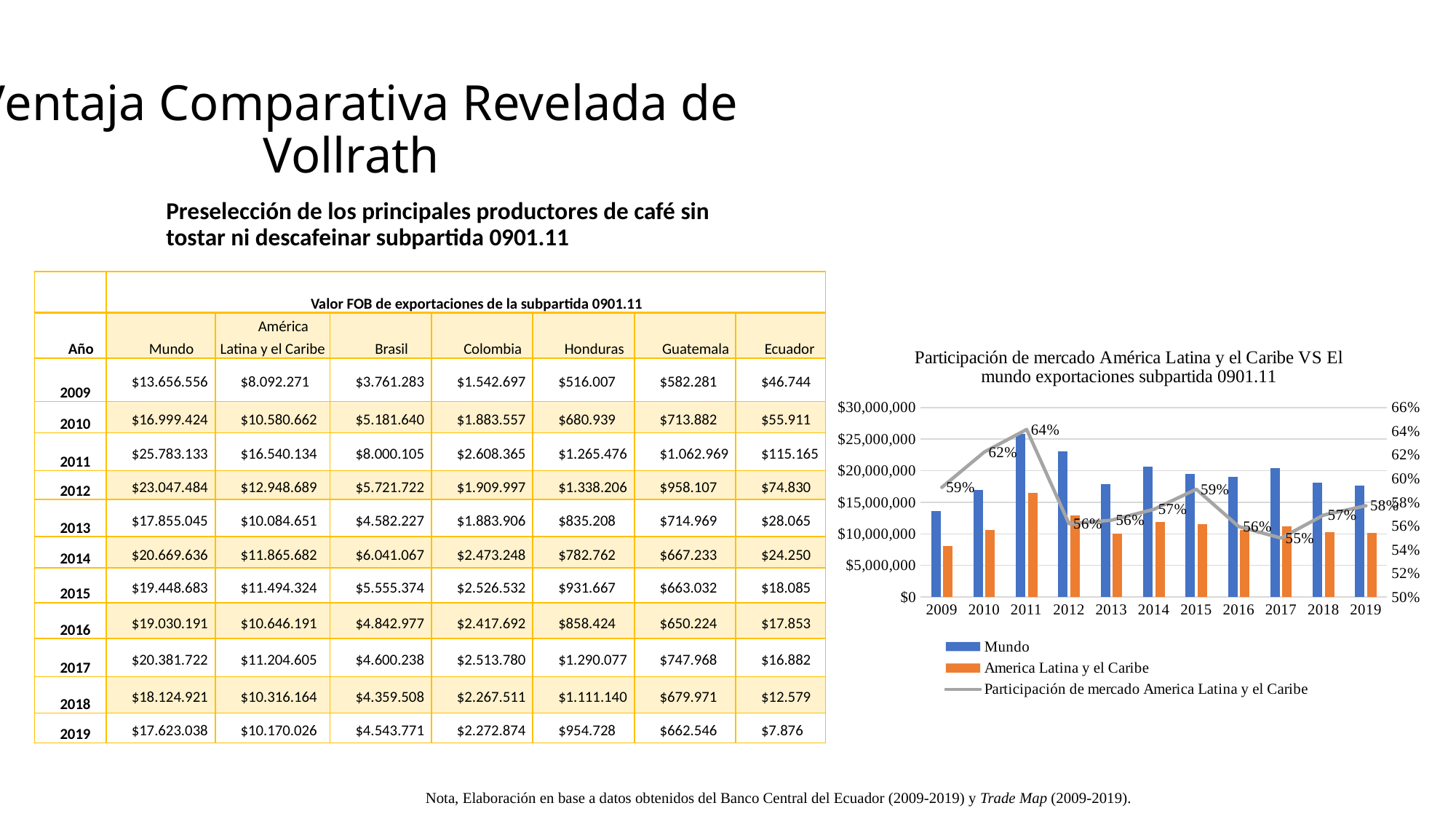
Is the America Latina y el Caribe bar for 2011 greater or less than $15,000,000? greater What is the market share value shown on the line for 2017? 55% How many series does the chart legend list? 3 In which year does the Participación de mercado line reach its lowest value? 2017 What is the difference between the highest (2011) and lowest (2017) market share values on the line? 9 percentage points What is the market share (Participación de mercado America Latina y el Caribe) shown for 2011? 64% Which is larger, the Mundo bar for 2011 or the Mundo bar for 2012? 2011 Is the Mundo bar for 2009 greater or less than $15,000,000? less Does the Participación de mercado line rise or fall from 2009 to 2011? rise In which year does the Participación de mercado line reach its highest value? 2011 Is the Mundo bar for 2011 greater or less than $20,000,000? greater How many years are shown on the x axis of the chart? 11